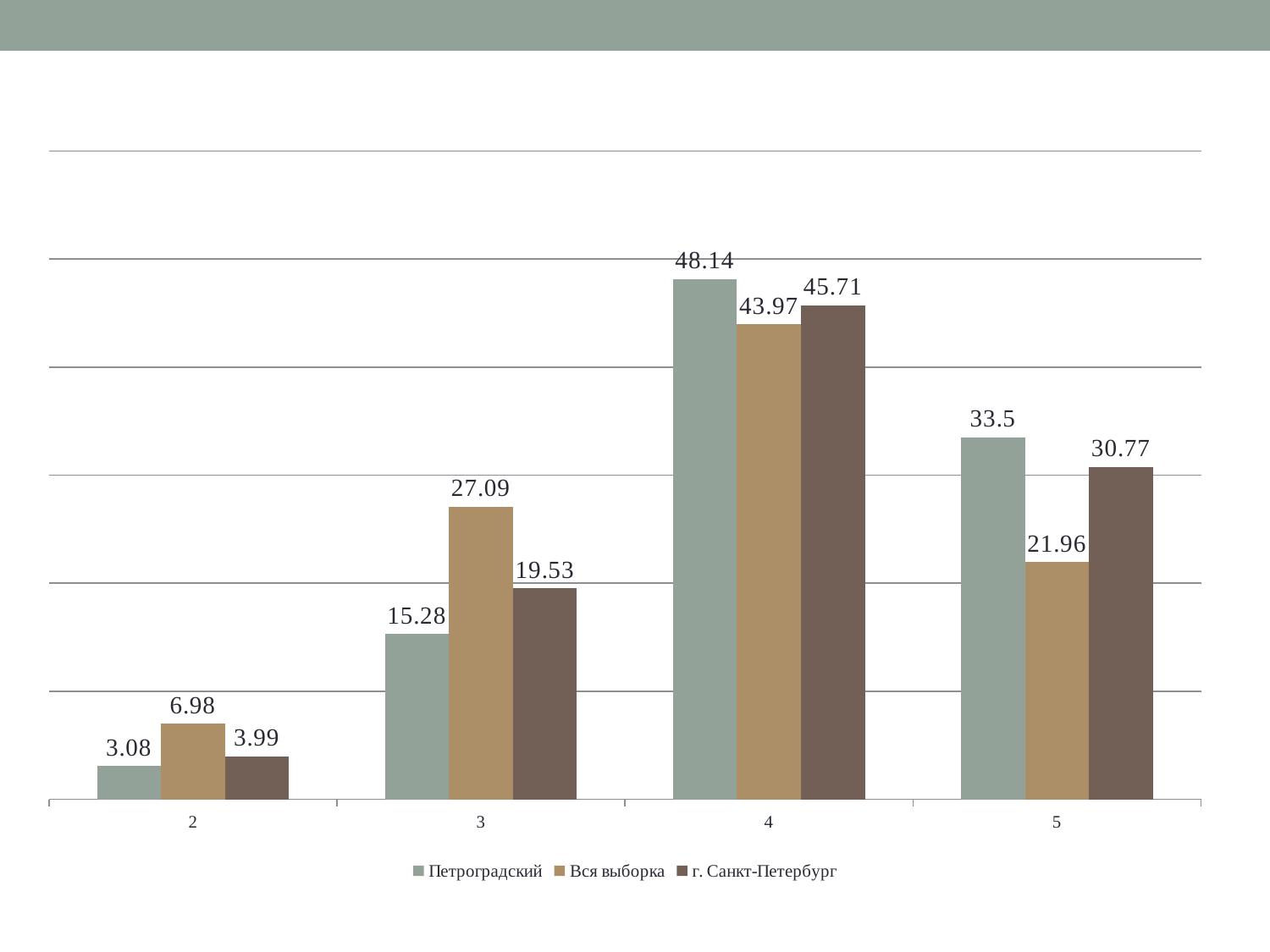
What kind of chart is shown on the slide? bar chart What is the difference between Петроградский and Вся выборка at category 5? 11.54 How many series does the legend list? 3 Which is larger at category 3: Вся выборка or г. Санкт-Петербург? Вся выборка What is the value for г. Санкт-Петербург at category 5? 30.77 What is the value for Вся выборка at category 3? 27.09 Which series is shown in the darkest brown colour? г. Санкт-Петербург Which category has the lowest value for г. Санкт-Петербург? 2 What is the value for Петроградский at category 2? 3.08 What is the value for Петроградский at category 4? 48.14 How many categories are shown on the x axis? 4 Which category has the highest value for Вся выборка? 4